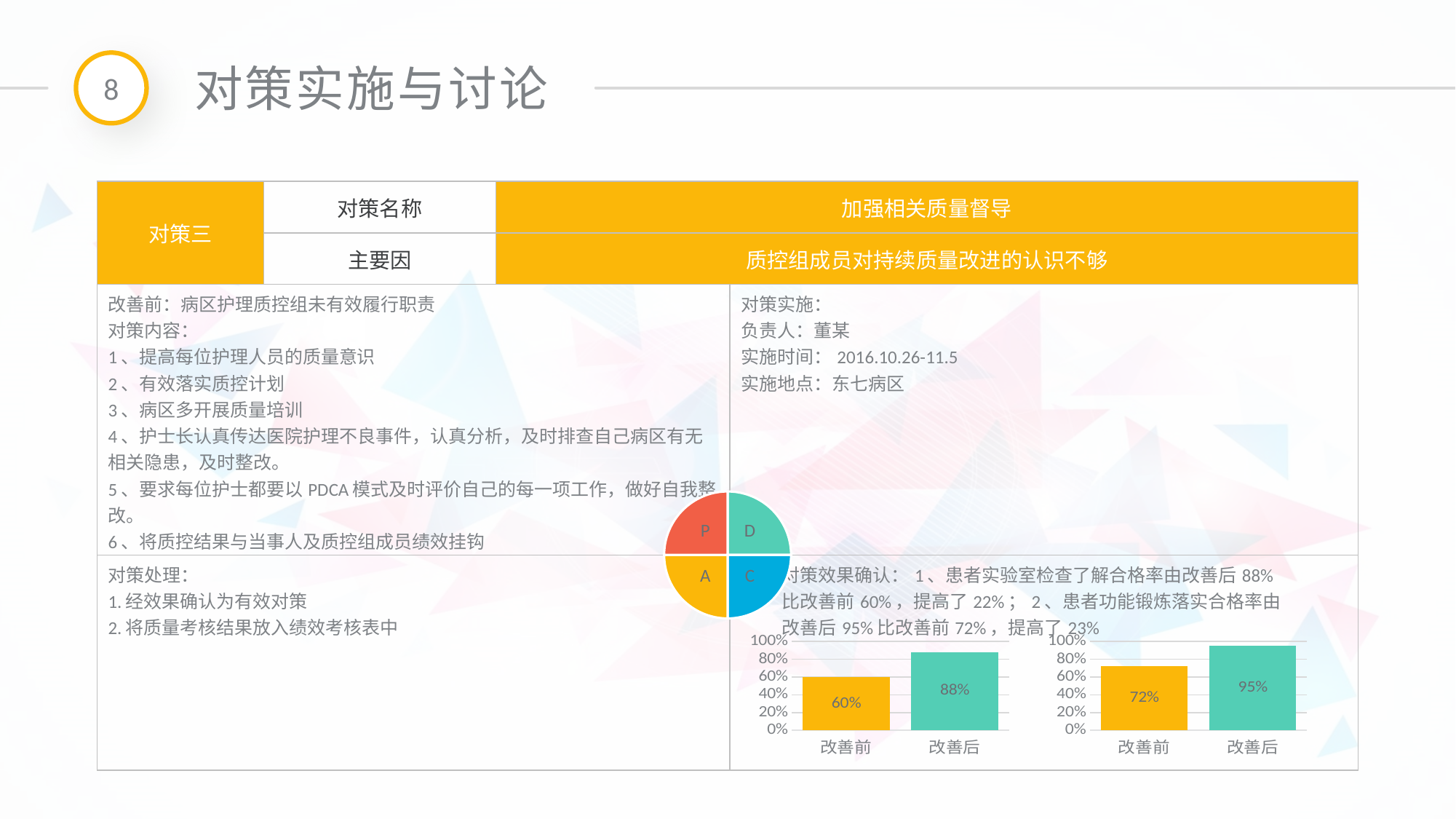
What type of chart is used at the bottom right of the slide to show 改善前 and 改善后? bar chart In the right bar chart at the bottom right of the slide, what is the difference between 改善后 and 改善前? 23% How many bars are shown in the left bar chart at the bottom right of the slide? 2 In the right bar chart at the bottom right of the slide, what is the value for 改善前? 72% In the left bar chart at the bottom right of the slide, what is the value for 改善前? 60% In the left bar chart at the bottom right of the slide, what is the value for 改善后? 88% Is the 改善前 value in the right bar chart larger or smaller than the 改善前 value in the left bar chart? larger In the right bar chart at the bottom right of the slide, which category has the lower value? 改善前 In the right bar chart at the bottom right of the slide, what is the value for 改善后? 95% In the right bar chart at the bottom right of the slide, what colour is the 改善后 bar? green In the left bar chart at the bottom right of the slide, what is the difference between 改善后 and 改善前? 28% In the left bar chart at the bottom right of the slide, which category has the higher value? 改善后